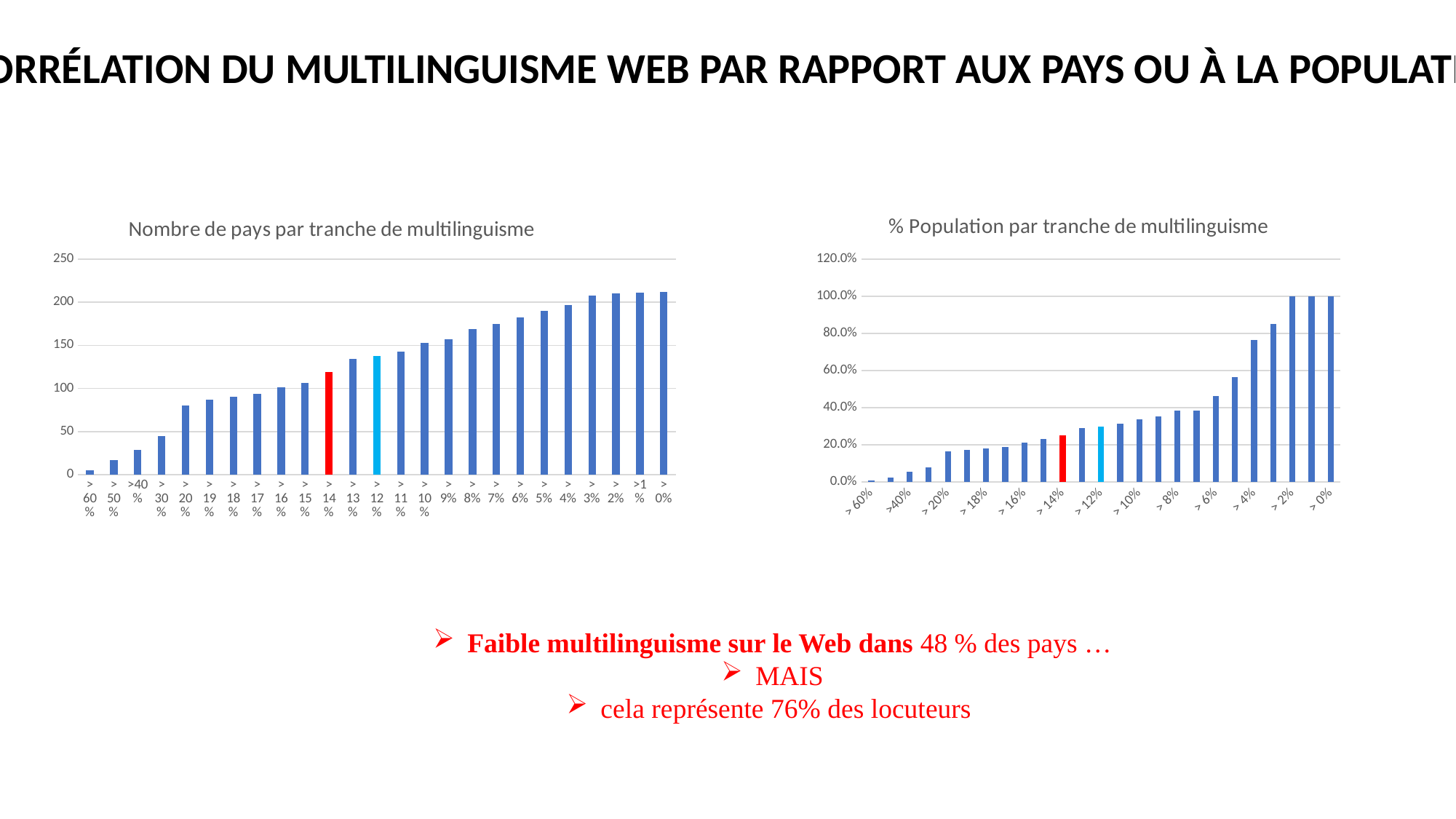
How many categories are shown on the x axis of the left chart 'Nombre de pays par tranche de multilinguisme'? 25 What type of chart is the left chart titled 'Nombre de pays par tranche de multilinguisme'? Bar chart In the left chart 'Nombre de pays par tranche de multilinguisme', which category is drawn as a red bar? >14% In the left chart 'Nombre de pays par tranche de multilinguisme', which category has the lowest value? >60% In the right chart '% Population par tranche de multilinguisme', is the value for >14% greater or less than 20.0%? greater In the left chart 'Nombre de pays par tranche de multilinguisme', is the value for >0% greater or less than 200? greater In the right chart '% Population par tranche de multilinguisme', is the value for >60% greater or less than 20.0%? less In the right chart '% Population par tranche de multilinguisme', which of >6% and >16% has the larger value? >6% In the left chart 'Nombre de pays par tranche de multilinguisme', do the values rise or fall from left to right along the x axis? Rise What is the title of the right chart? % Population par tranche de multilinguisme